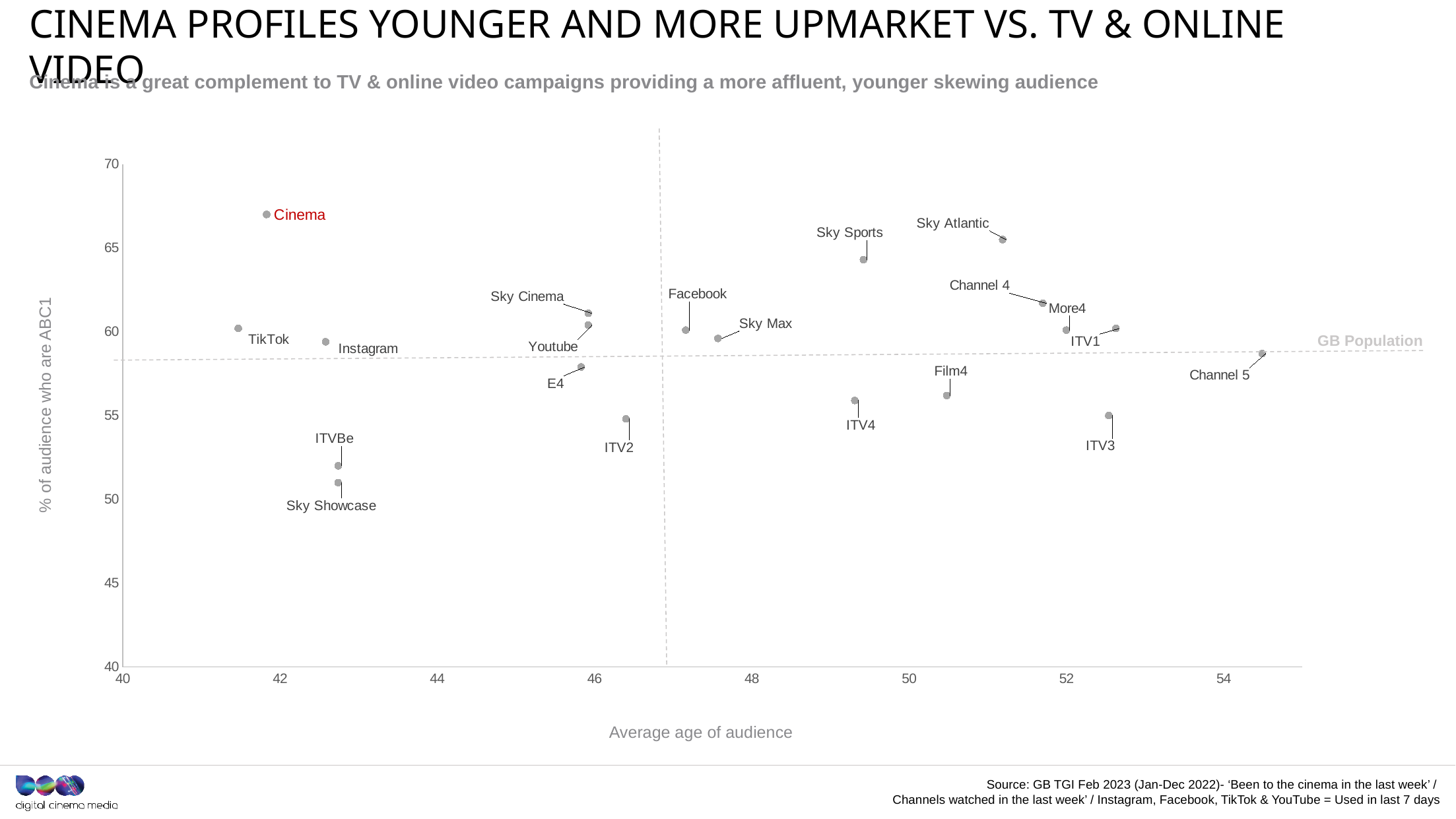
Which has a higher % of audience who are ABC1, Cinema or Sky Atlantic? Cinema What kind of chart is shown on the slide? Scatter chart Is the % of audience who are ABC1 for Cinema greater or less than 65? greater Which point has the highest % of audience who are ABC1? Cinema Which point has the highest average age of audience? Channel 5 How many labelled data points are plotted on the chart? 20 Which point has the lowest % of audience who are ABC1? Sky Showcase Is the average age of audience for Channel 5 greater or less than 54? greater Is the % of audience who are ABC1 for Sky Showcase greater or less than 55? less What does the horizontal dashed line on the chart represent? GB Population Which has a higher average age of audience, TikTok or Channel 5? Channel 5